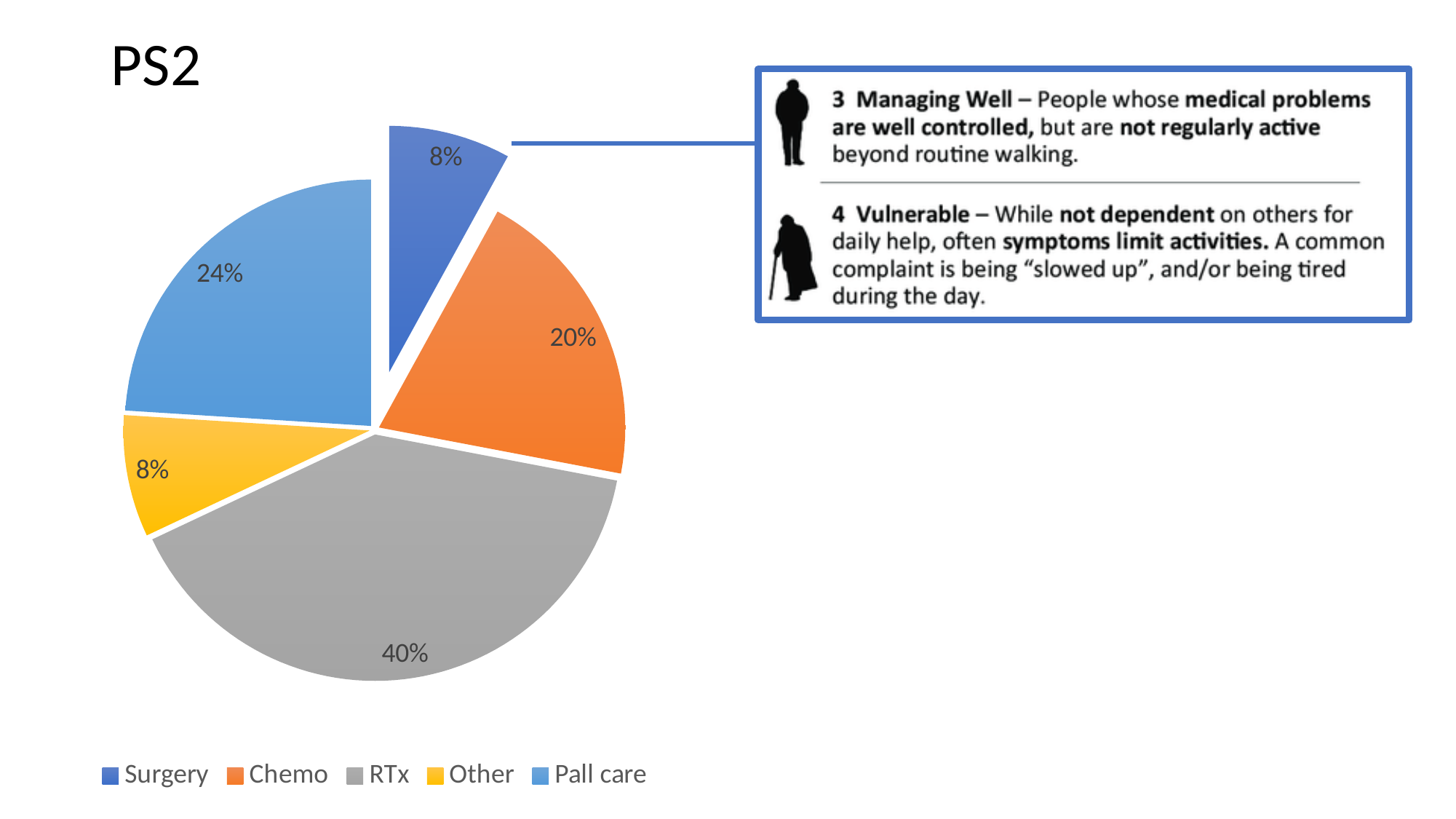
Which category has the largest share of the pie? RTx Which is larger, Chemo or Pall care? Pall care What type of chart is shown on the slide? Pie chart What is the title of the chart? PS2 What percentage of the pie is Other? 8% Which slice is pulled out from the rest of the pie? Surgery What is the difference in percentage points between RTx and Pall care? 16 How many categories does the legend list? 5 What percentage of the pie is Pall care? 24% What percentage of the pie is Surgery? 8% What percentage of the pie is RTx? 40% What percentage of the pie is Chemo? 20%